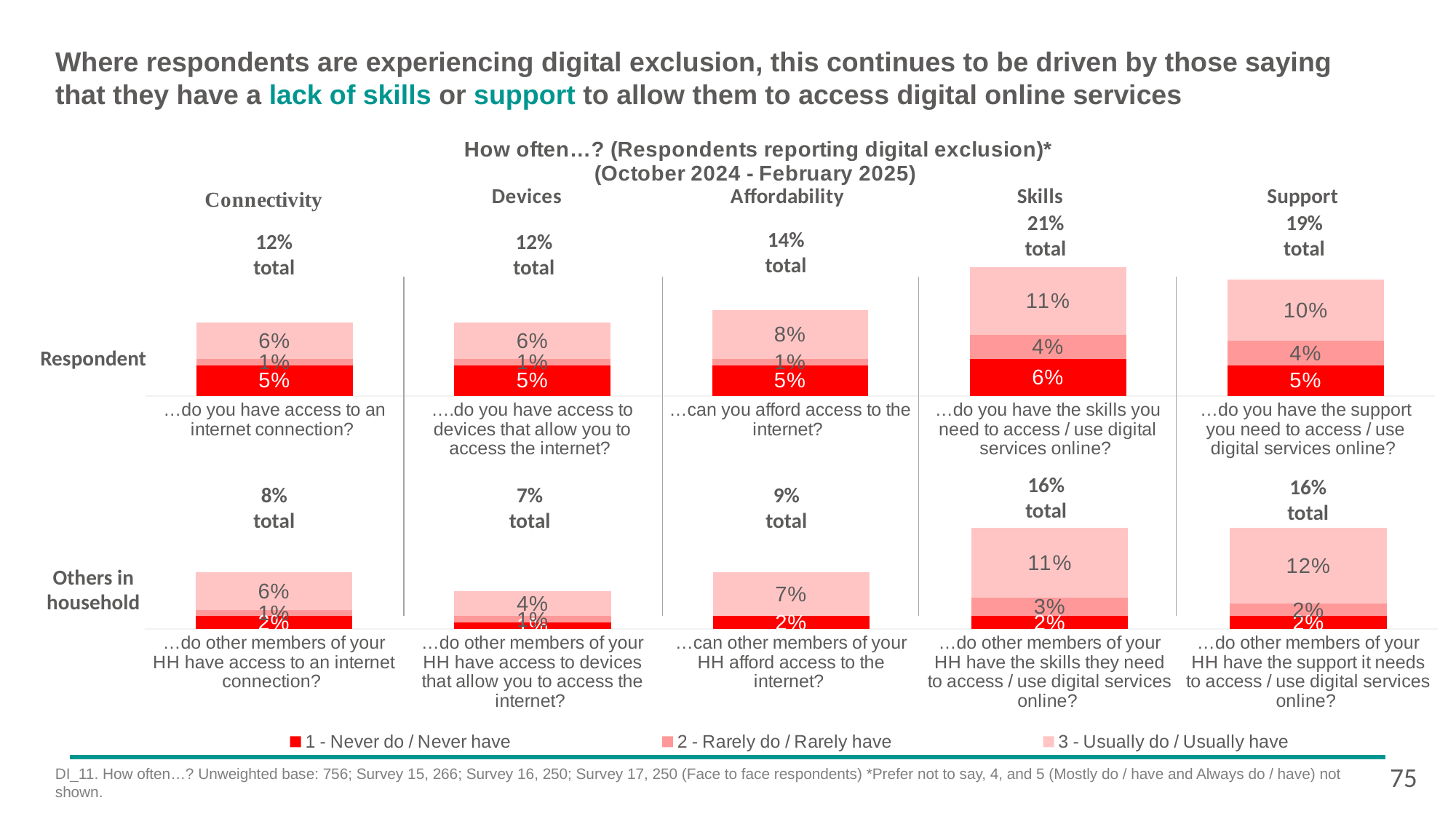
Which legend entry is shown in the darkest red colour? 1 - Never do / Never have What kind of chart is used on this slide? Stacked bar chart How many series does the legend list? 3 In the Respondent row, what is the total shown for Skills? 21% In the Respondent row, what is the value of the '3 - Usually do / Usually have' segment for Support? 10% In the Others in household row, what is the value of the '3 - Usually do / Usually have' segment for Support? 12% In the Respondent row, which category has the highest total? Skills In the Others in household row, which category has the lowest total? Devices In the Respondent row, what is the value of the '1 - Never do / Never have' segment for Affordability? 5% In the Others in household row, which has the larger total: Skills or Devices? Skills In the Others in household row, what is the total shown for Connectivity? 8% In the Respondent row, what is the difference between the Skills total and the Connectivity total? 9 percentage points